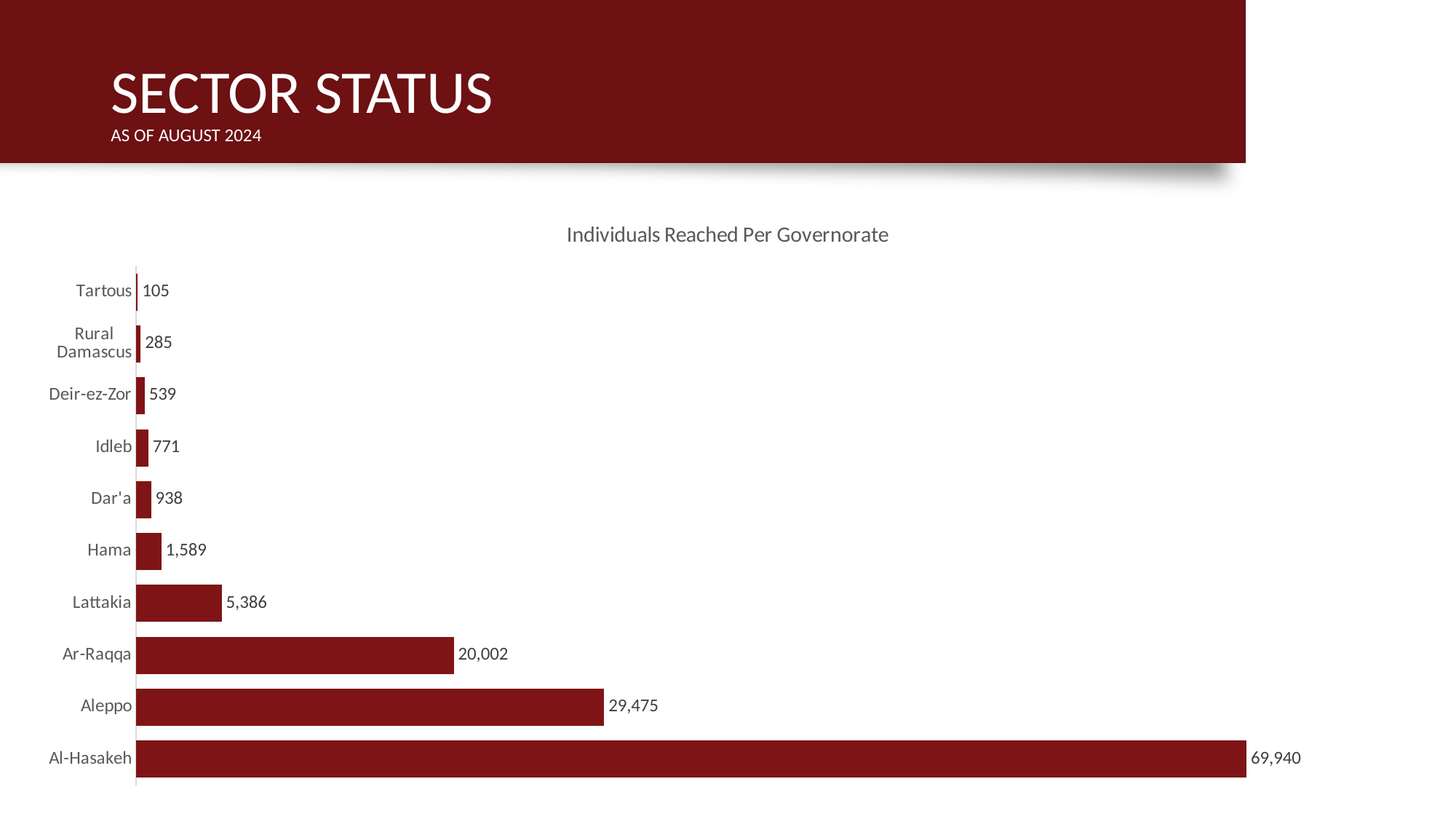
Which has a larger value, Idleb or Dar'a? Dar'a How many individuals were reached in Rural Damascus? 285 Which governorate has the highest number of individuals reached? Al-Hasakeh What type of chart is shown on the slide? Bar chart What is the difference between the values for Al-Hasakeh and Aleppo? 40,465 What is the difference between the values for Ar-Raqqa and Lattakia? 14,616 What is the value for Lattakia? 5,386 How many individuals were reached in Aleppo? 29,475 How many governorates are shown in the chart? 10 What is the title of the chart? Individuals Reached Per Governorate Which governorate has the lowest number of individuals reached? Tartous Which has a larger value, Hama or Deir-ez-Zor? Hama